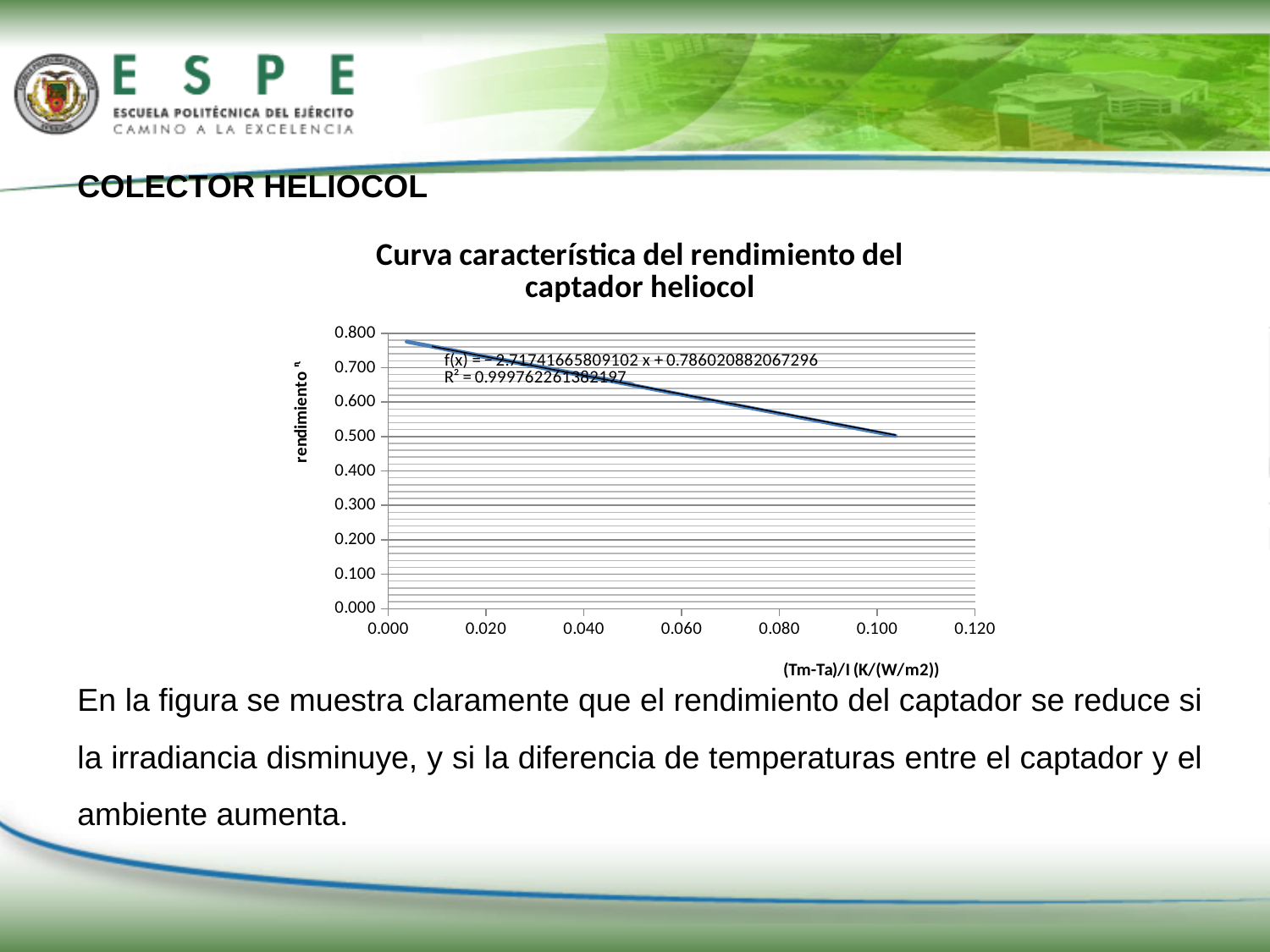
What is the label of the vertical axis of the chart? rendimiento ƞ What is the title of the chart? Curva característica del rendimiento del captador heliocol Is the rendimiento value at x = 0.060 greater or less than 0.500? greater Is the rendimiento value at the left end of the line (near x = 0.000) greater or less than 0.700? greater What kind of chart is shown on the slide? line chart What is the R² value shown for the trendline on the chart? 0.999762261382197 Is the rendimiento value at the right end of the line (around x = 0.100) greater or less than 0.600? less Does the plotted line rise or fall as (Tm-Ta)/I increases along the x axis? fall What is the highest tick value shown on the vertical axis of the chart? 0.800 What is the intercept of the trendline equation f(x) shown on the chart? 0.786020882067296 What is the slope of the trendline equation f(x) shown on the chart? -2.71741665809102